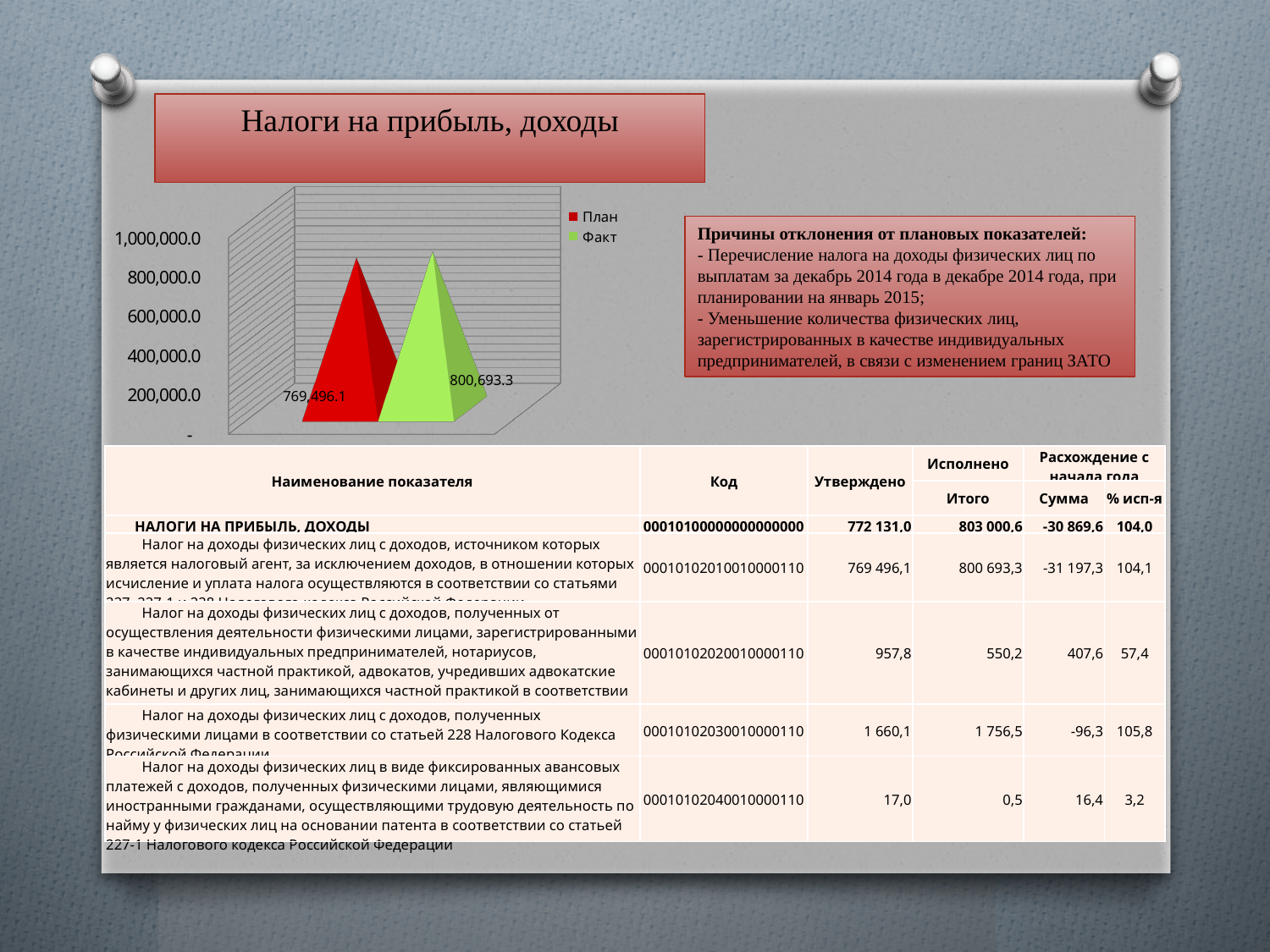
What is the difference between the Факт value and the План value in the chart? 31,197.2 What colour represents the Факт series in the chart? green Which series shows the highest value in the chart? Факт What is the value of the План series in the chart? 769,496.1 What is the value of the Факт series in the chart? 800,693.3 Is the value for Факт greater or less than 600,000.0? greater Which series has the higher value in the chart, План or Факт? Факт What kind of chart is shown on the slide? bar chart How many series does the chart legend list? 2 Which series shows the lowest value in the chart? План How many bars are plotted in the chart? 2 Is the value for План greater or less than 800,000.0? less